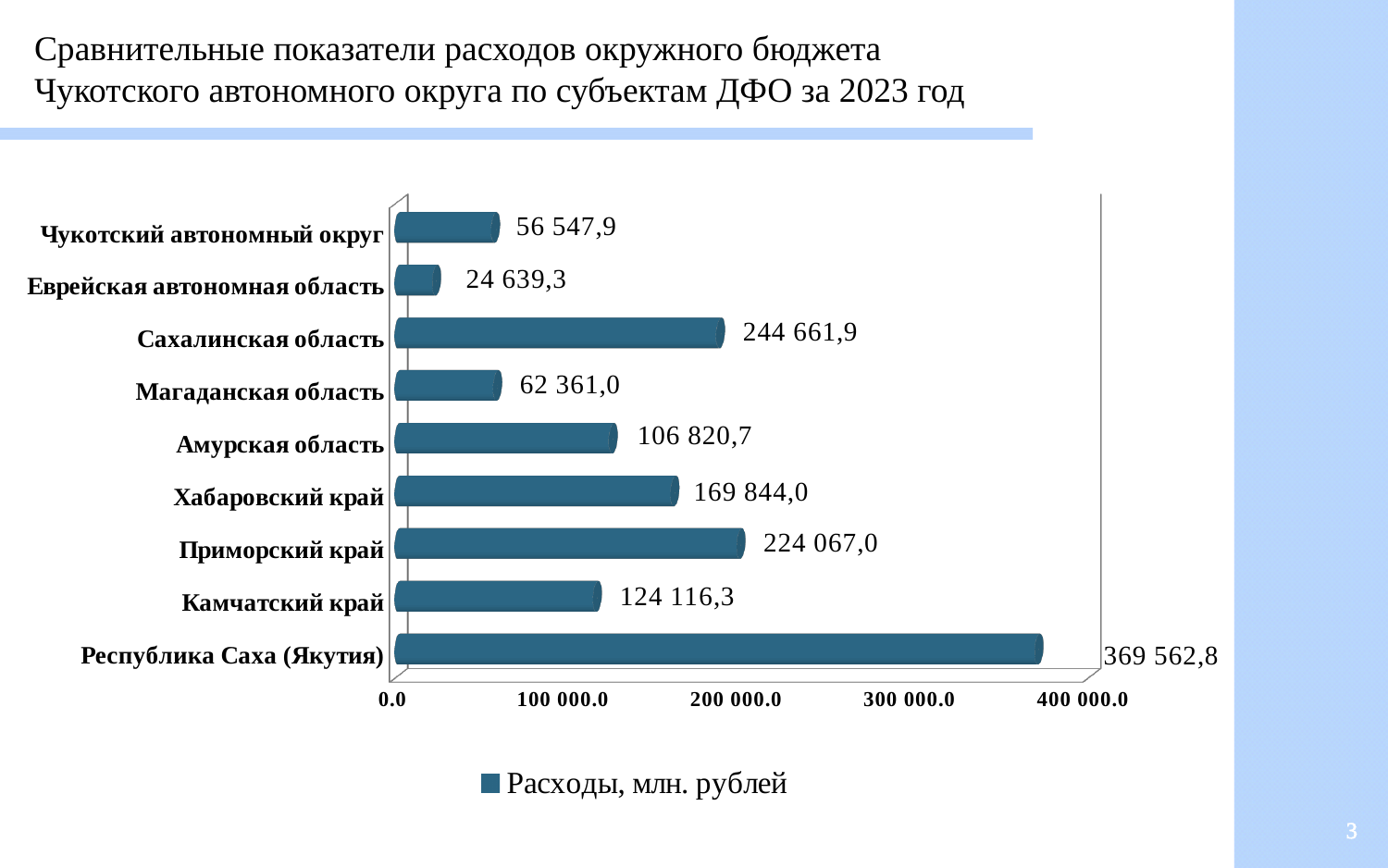
What is the difference between the values for Магаданская область and Чукотский автономный округ? 5 813,1 What is the value for Чукотский автономный округ? 56 547,9 How many regions are shown in the chart? 9 Which region has the lowest value? Еврейская автономная область What is the value for Камчатский край? 124 116,3 What kind of chart is shown on the slide? bar chart What is the legend entry of the chart? Расходы, млн. рублей What is the value for Хабаровский край? 169 844,0 Which region has the highest value? Республика Саха (Якутия) What is the difference between the values for Сахалинская область and Приморский край? 20 594,9